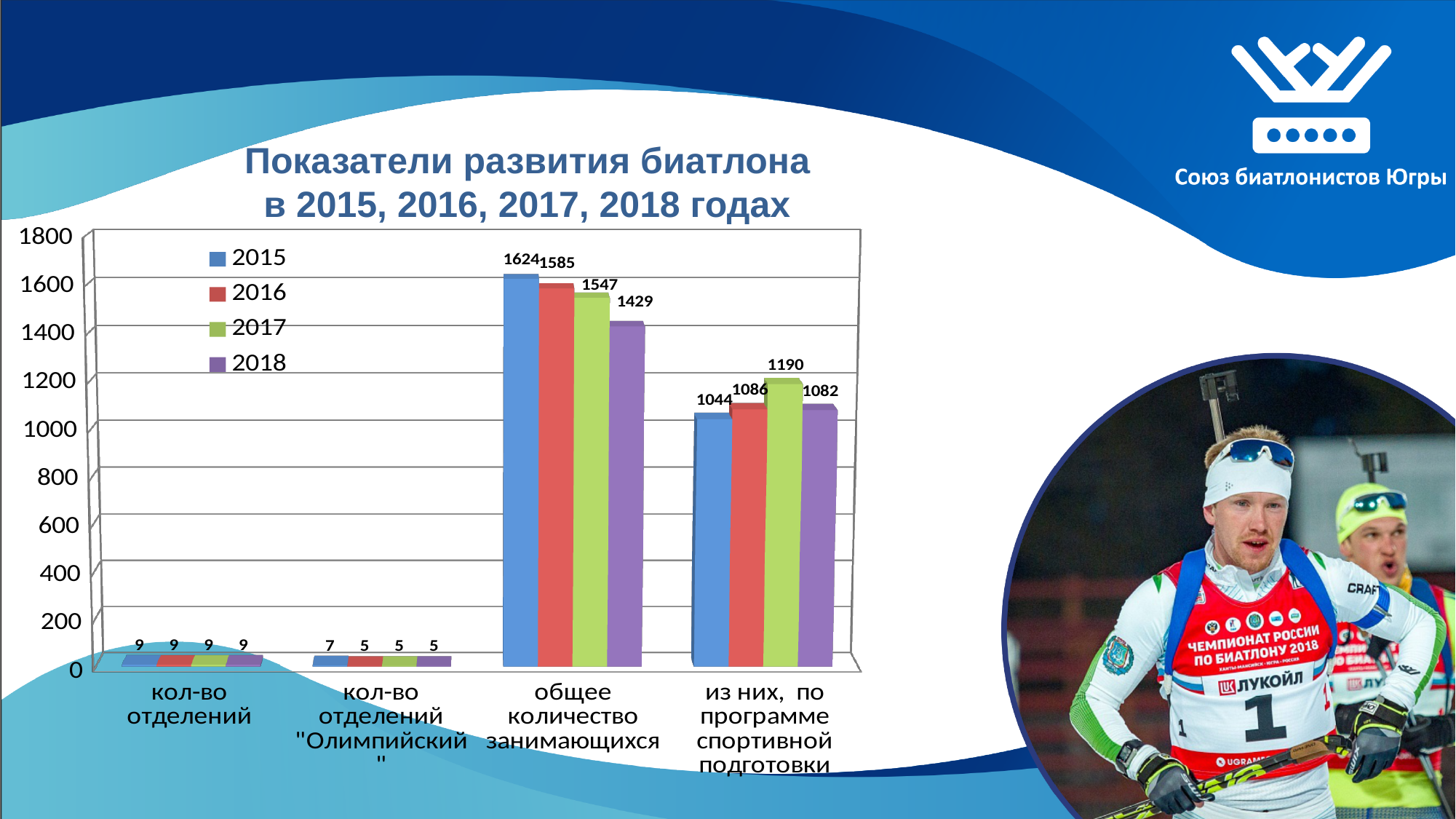
What is the value for 2017 in the category "из них, по программе спортивной подготовки"? 1190 What is the value for 2015 in the category "общее количество занимающихся"? 1624 Which year has the highest value in the category "из них, по программе спортивной подготовки"? 2017 How many categories are shown on the x axis of the chart? 4 What is the value for 2018 in the category "общее количество занимающихся"? 1429 Which is larger in the category "из них, по программе спортивной подготовки": the value for 2016 or the value for 2018? 2016 Do the values in the category "общее количество занимающихся" rise or fall from 2015 to 2018? fall What is the value for 2015 in the category "кол-во отделений "Олимпийский""? 7 What is the difference between the 2015 and 2018 values in the category "общее количество занимающихся"? 195 Which year has the lowest value in the category "общее количество занимающихся"? 2018 How many series does the legend list? 4 What kind of chart is shown on the slide? bar chart